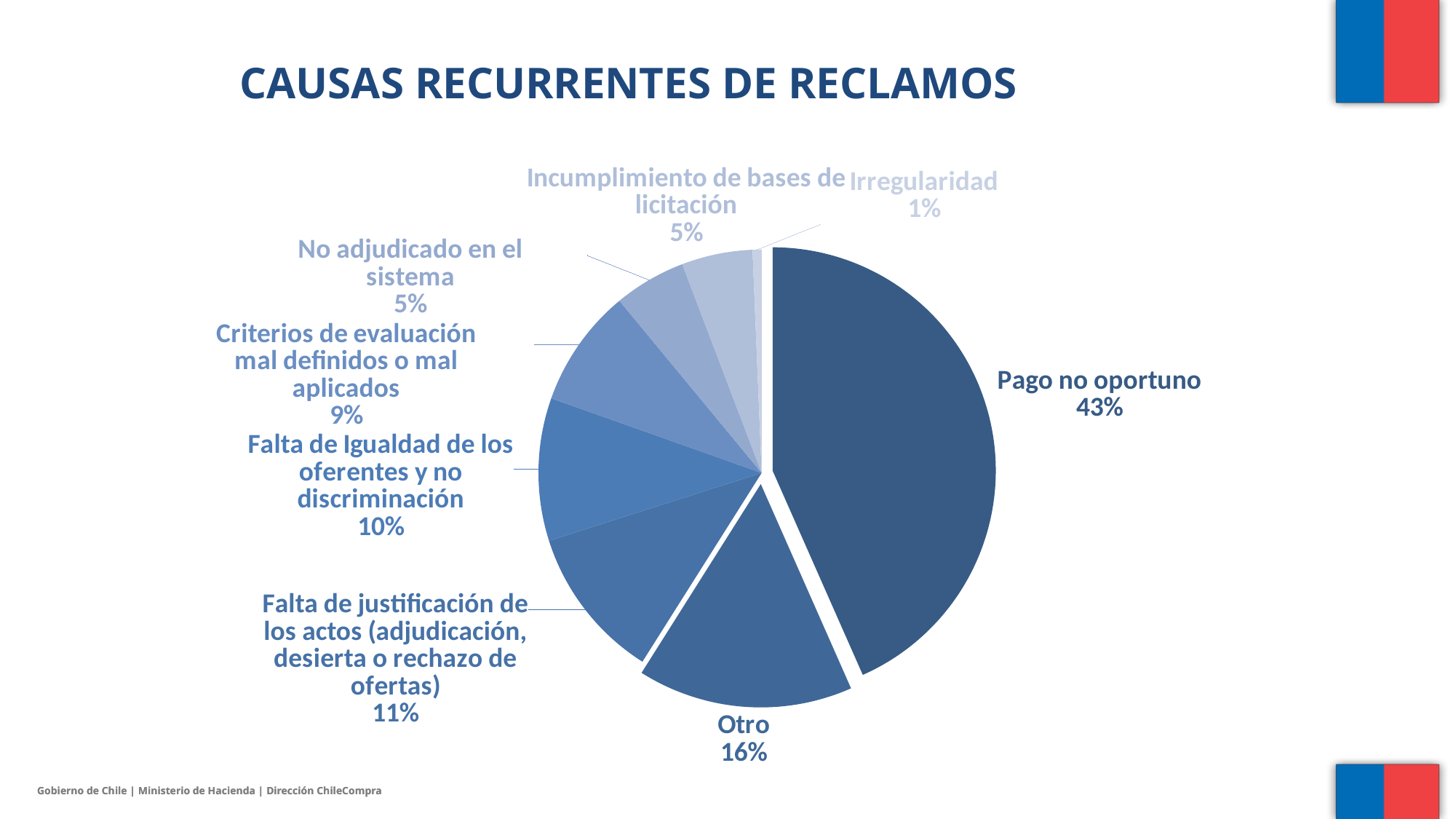
Which category has the smallest share of the pie? Irregularidad What percentage is shown for "Falta de justificación de los actos (adjudicación, desierta o rechazo de ofertas)"? 11% Which category has the largest share of the pie? Pago no oportuno How many categories (slices) does the pie chart have? 8 What is the value for "Irregularidad"? 1% What percentage is shown for "Criterios de evaluación mal definidos o mal aplicados"? 9% What share of the pie does "Pago no oportuno" represent? 43% What is the value for "Falta de Igualdad de los oferentes y no discriminación"? 10% What is the difference in percentage points between "Pago no oportuno" and "Otro"? 27 What type of chart is shown on the slide? Pie chart What is the value shown for "Otro"? 16% Which is larger, "Falta de justificación de los actos" or "Falta de Igualdad de los oferentes y no discriminación"? Falta de justificación de los actos